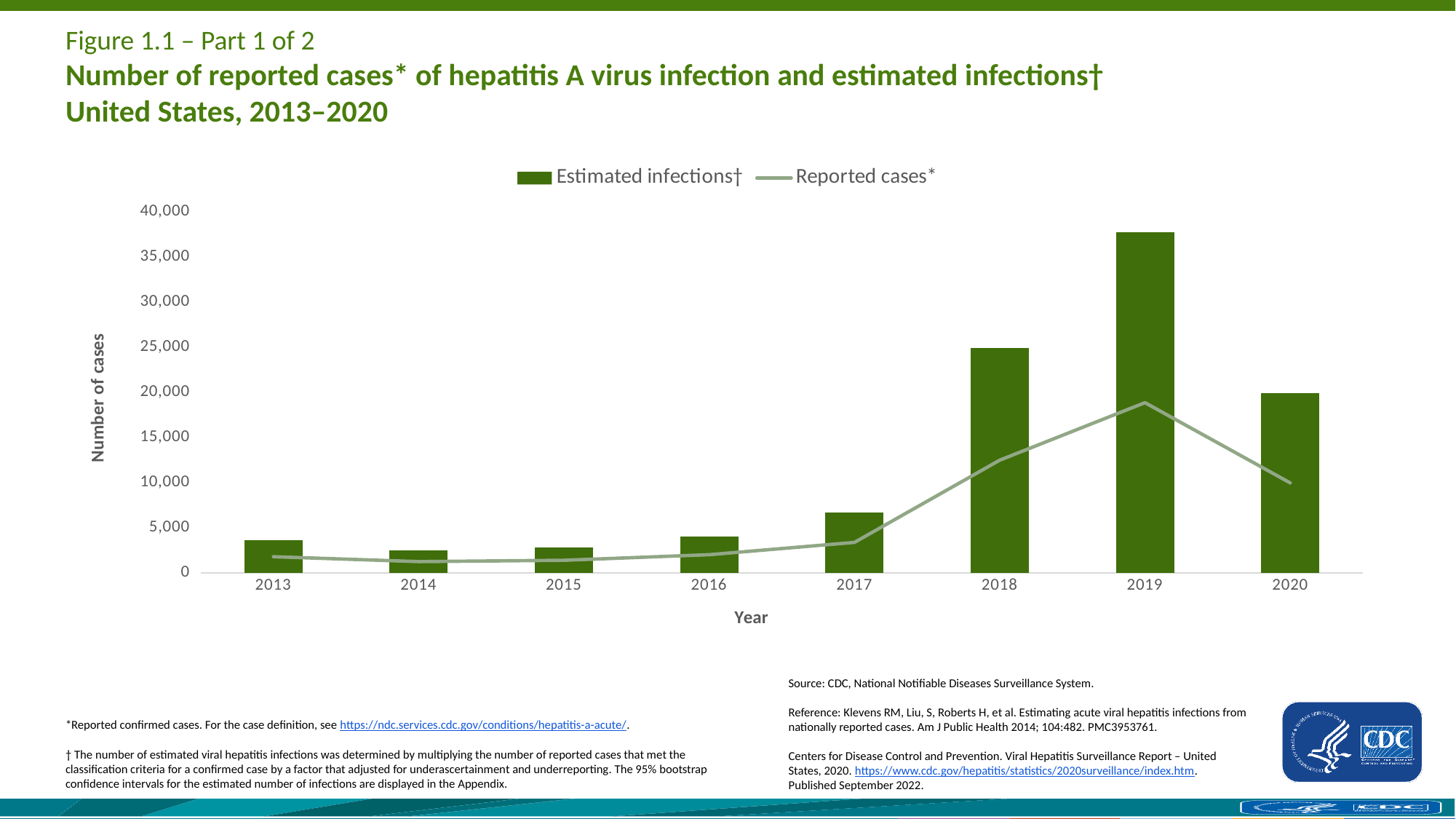
Do estimated infections rise or fall from 2016 to 2019? rise Which year has the highest number of estimated infections? 2019 Is the value for reported cases in 2019 greater or less than 15,000? greater How many years are shown on the x axis? 8 Which year has the highest number of reported cases? 2019 How many series does the legend list? 2 Is the value for estimated infections in 2019 greater or less than 35,000? greater Which year has the lowest number of estimated infections? 2014 What kind of chart is shown on the slide? A combined bar and line chart Which series is drawn as a line rather than bars? Reported cases* Which is larger, the estimated infections in 2018 or in 2020? 2018 Is the value for estimated infections in 2017 greater or less than 5,000? greater